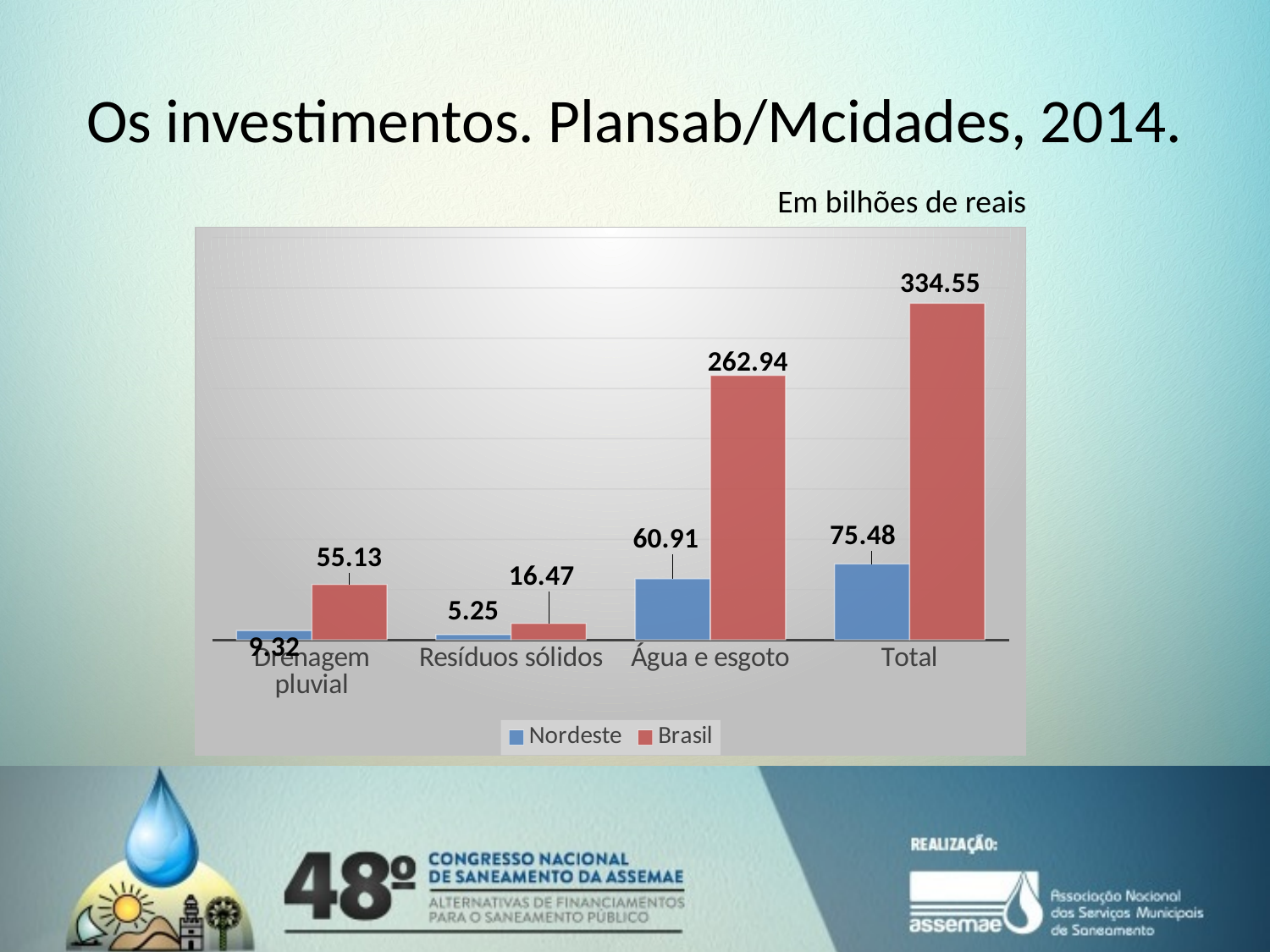
Which category has the lowest Nordeste value? Resíduos sólidos How many categories are shown on the x axis? 4 What is the Brasil value for Resíduos sólidos? 16.47 What is the difference between the Brasil and Nordeste values for Água e esgoto? 202.03 What unit is stated for the values in the chart? Em bilhões de reais Excluding Total, which category has the highest Brasil value? Água e esgoto What is the difference between the Brasil and Nordeste values for Total? 259.07 Which is larger: the Nordeste value for Água e esgoto or the Brasil value for Drenagem pluvial? Nordeste value for Água e esgoto What is the Brasil value for Água e esgoto? 262.94 What is the Nordeste value for Drenagem pluvial? 9.32 What is the Nordeste value for Total? 75.48 How many series does the legend list? 2